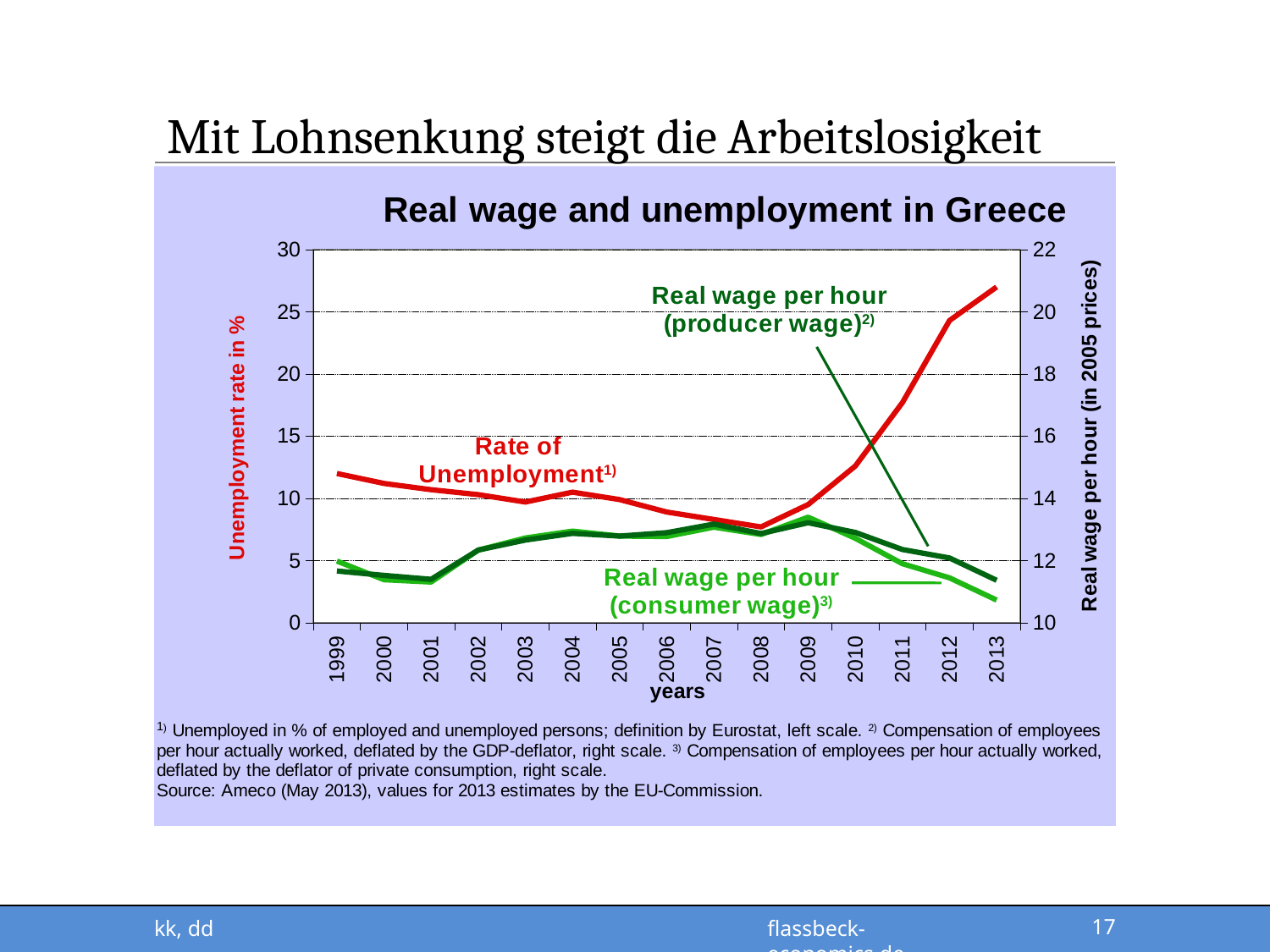
Does the Real wage per hour (producer wage) rise or fall between 2009 and 2013? fall What kind of chart is shown on the slide? line chart Is the Rate of Unemployment in 2008 greater or less than 10? less Does the Rate of Unemployment rise or fall between 2009 and 2013? rise Is the Rate of Unemployment in 1999 greater or less than 10? greater How many years are shown on the x axis of the chart? 15 In which year is the Rate of Unemployment highest? 2013 Is the Rate of Unemployment in 2013 greater or less than 25? greater What is the title of the chart? Real wage and unemployment in Greece What is the label of the left vertical axis? Unemployment rate in % How many data series are plotted in the chart? 3